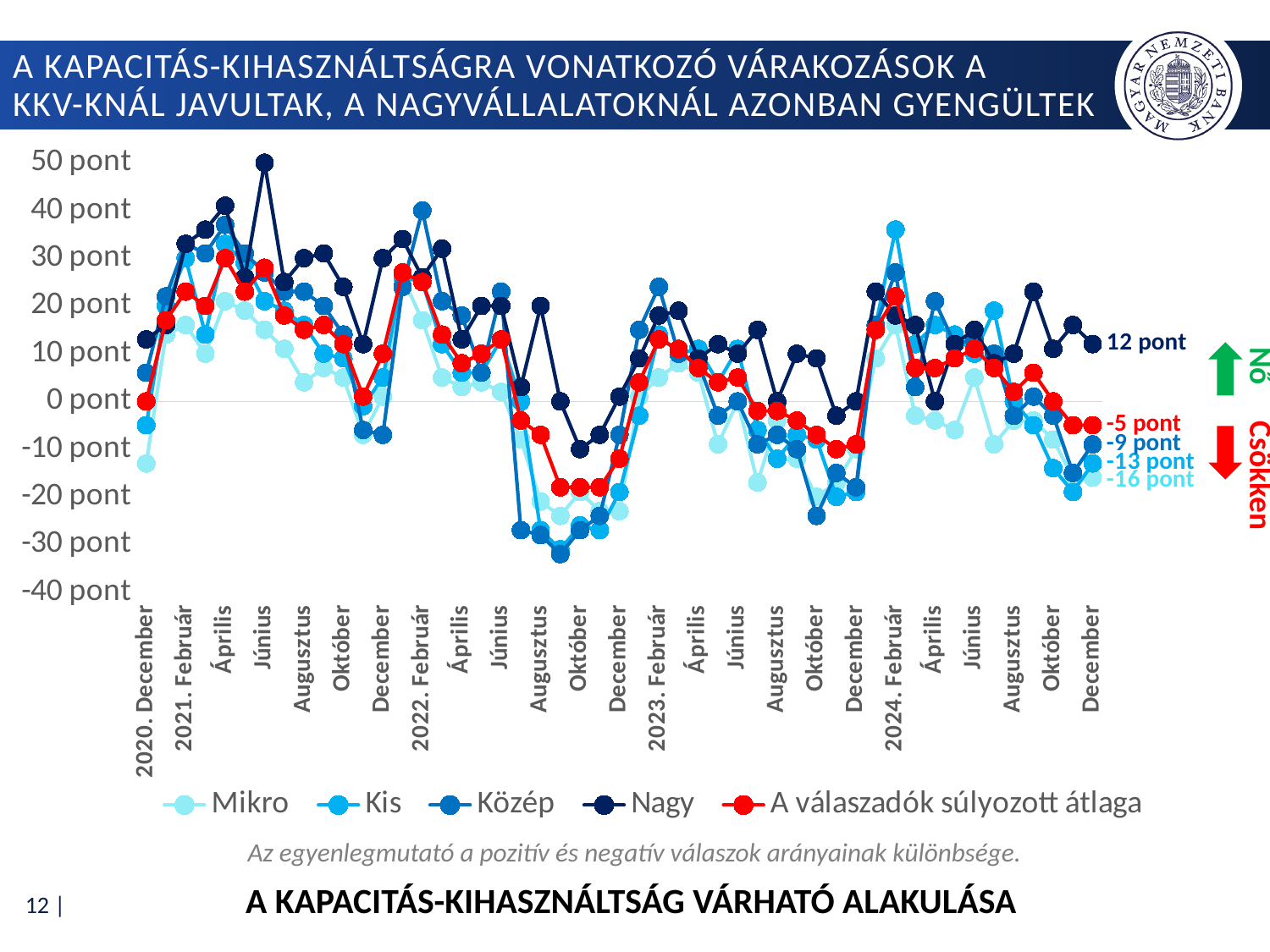
What is the value of the Mikro series at the last data point (2024 December)? -16 pont What is the value of the Közép series at the last data point (2024 December)? -9 pont What is the difference between the Nagy and Mikro values at the last data point (2024 December)? 28 pont What is the value of 'A válaszadók súlyozott átlaga' at the last data point (2024 December)? -5 pont How many series does the legend list? 5 Which series has the highest value at the last data point (2024 December)? Nagy What is the value of the Kis series at the last data point (2024 December)? -13 pont Is the value of the Nagy series in 2021 Június greater or less than 40 pont? greater What is the value of the Nagy series at the last data point (2024 December)? 12 pont What kind of chart is shown on the slide? line chart Which series has the lowest value at the last data point (2024 December)? Mikro At the last data point (2024 December), is the Közép value larger or the Kis value? Közép